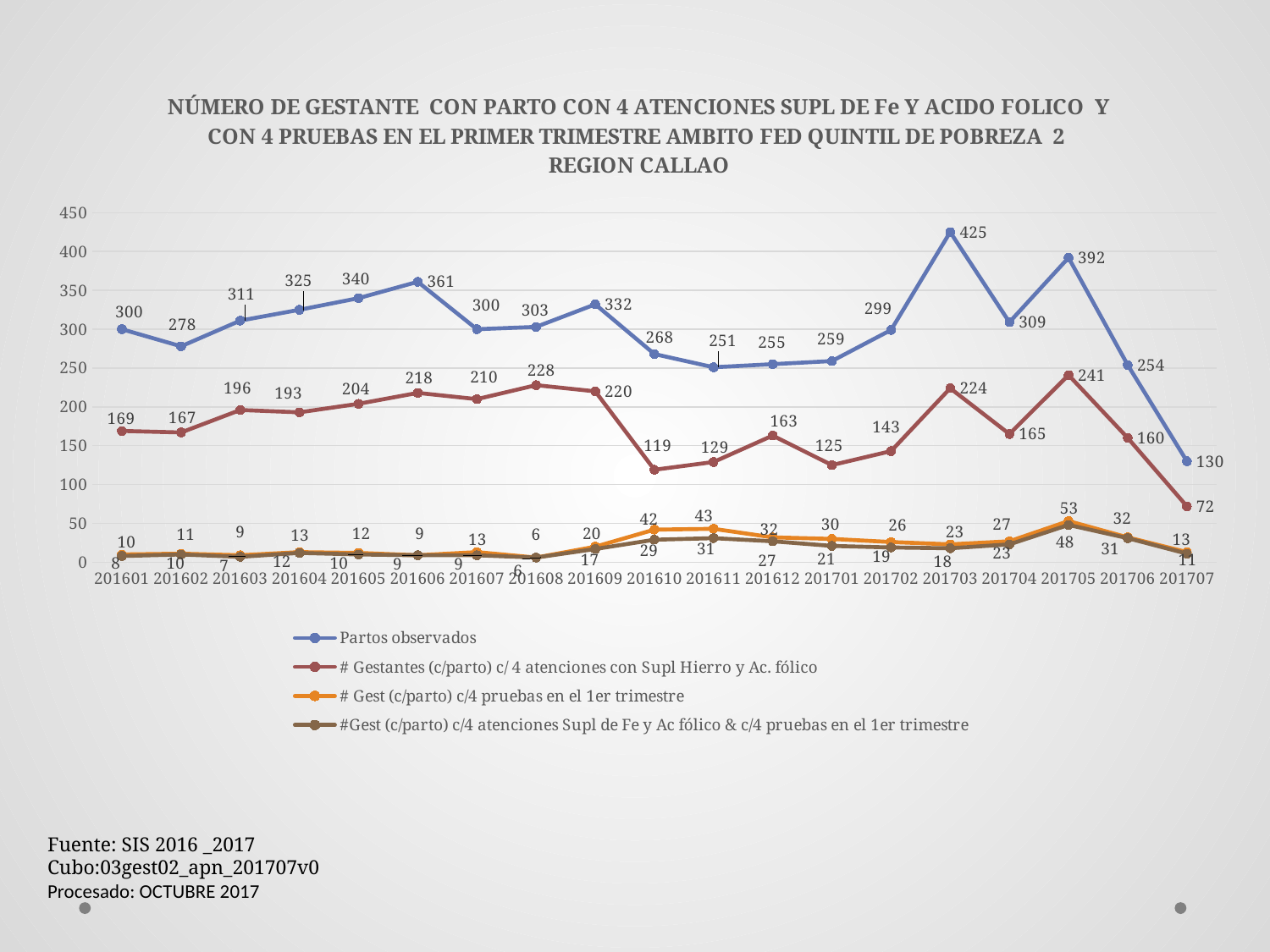
What is the value of '# Gestantes (c/parto) c/ 4 atenciones con Supl Hierro y Ac. fólico' in 201705? 241 Do the values of Partos observados rise or fall from 201705 to 201707? Fall What is the value of '# Gest (c/parto) c/4 pruebas en el 1er trimestre' in 201705? 53 What kind of chart is shown on the slide? Line chart Which period has a larger value for Partos observados, 201601 or 201707? 201601 How many series does the legend list? 4 What is the value of '#Gest (c/parto) c/4 atenciones Supl de Fe y Ac fólico & c/4 pruebas en el 1er trimestre' in 201705? 48 What is the difference between Partos observados in 201703 and in 201705? 33 How many periods are shown on the x axis? 19 In which period is Partos observados lowest? 201707 In which period is Partos observados highest? 201703 What is the value of Partos observados in 201703? 425